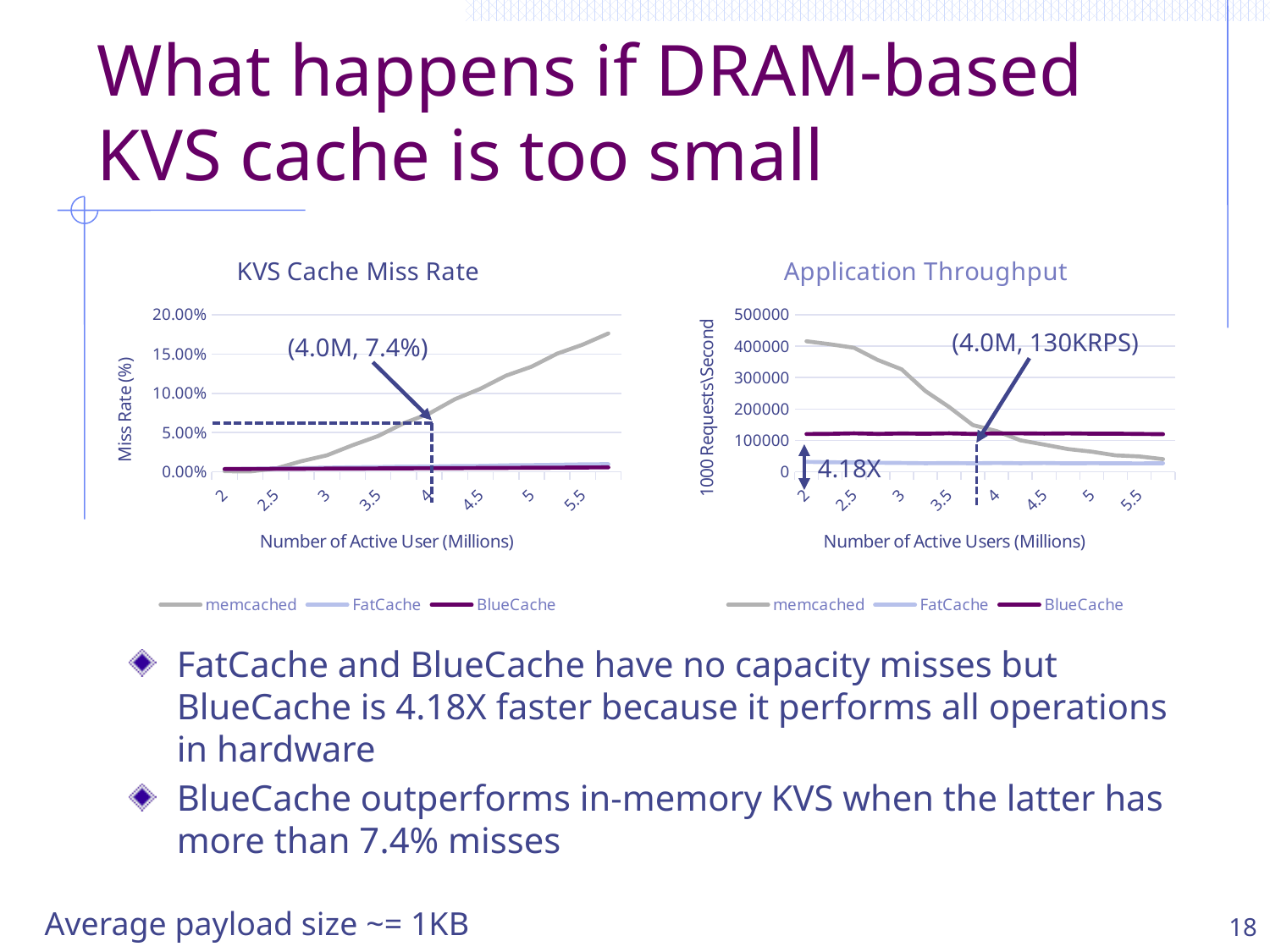
How many points are marked on the x axis of the KVS Cache Miss Rate chart? 8 In the KVS Cache Miss Rate chart, is the memcached miss rate at 5.5 million users greater or less than 15.00%? greater In the Application Throughput chart, which series has the higher throughput at 5.5 million users, BlueCache or memcached? BlueCache In the Application Throughput chart, is the memcached throughput at 2 million users greater or less than 400000? greater In the Application Throughput chart, does the memcached throughput rise or fall as the number of active users increases? fall What is the y-axis label of the Application Throughput chart? 1000 Requests\Second In the Application Throughput chart, what throughput does the annotation give at 4.0M active users? 130KRPS In the Application Throughput chart, which series has the highest throughput at 2 million users? memcached In the KVS Cache Miss Rate chart, what miss rate does the annotation give for memcached at 4.0M active users? 7.4% What kind of chart is the KVS Cache Miss Rate chart? line chart In the KVS Cache Miss Rate chart, does the memcached miss rate rise or fall as the number of active users increases? rise How many series does the legend of the Application Throughput chart list? 3